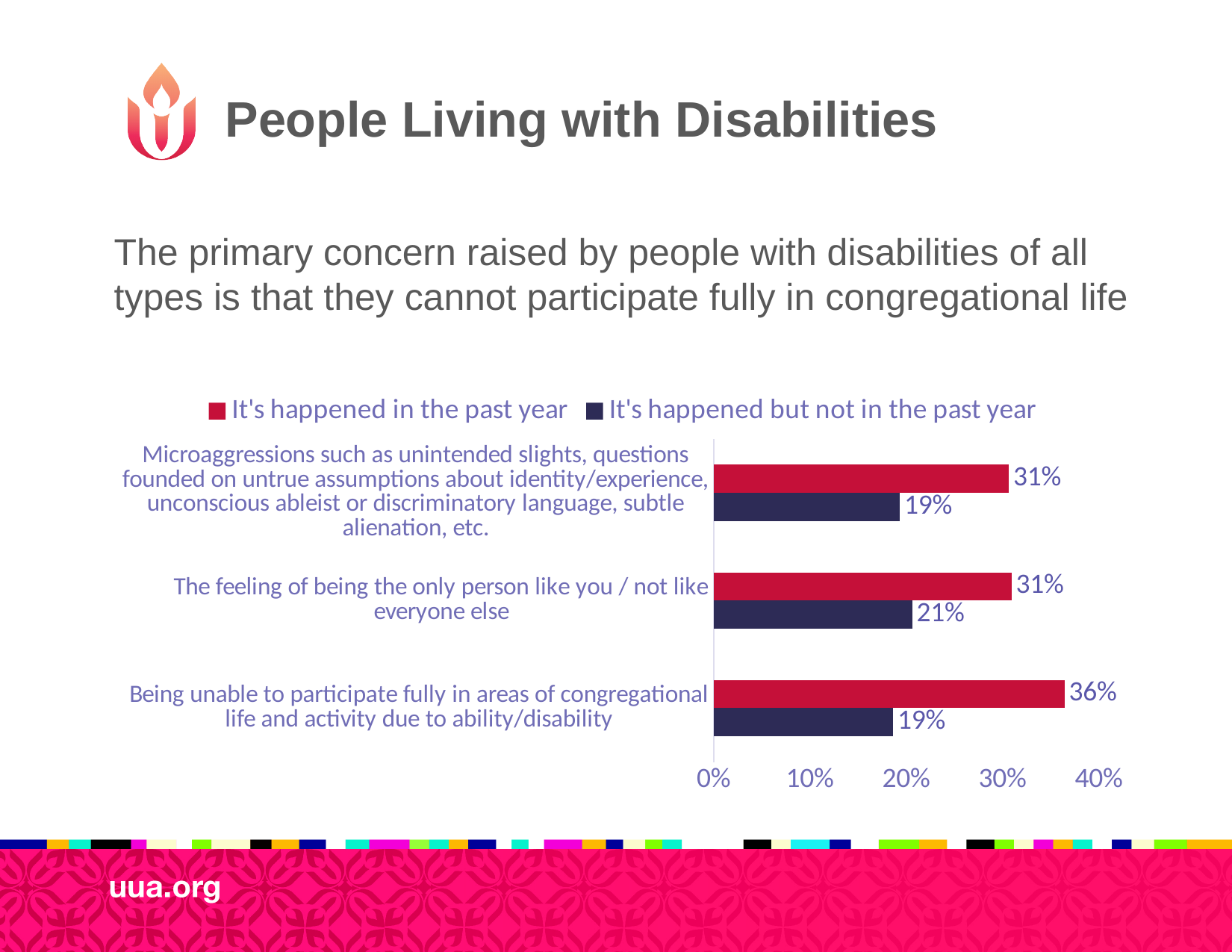
Which category has the highest value for "It's happened in the past year"? Being unable to participate fully in areas of congregational life and activity due to ability/disability What colour are the bars for "It's happened in the past year"? Red How many categories are plotted in the chart? 3 For the microaggressions category, which series has the larger value? It's happened in the past year Which category has the highest value for "It's happened but not in the past year"? The feeling of being the only person like you / not like everyone else What is the value for "It's happened but not in the past year" for "The feeling of being the only person like you / not like everyone else"? 21% What kind of chart is shown on the slide? Bar chart What is the value for "It's happened in the past year" for "Being unable to participate fully in areas of congregational life and activity due to ability/disability"? 36% Is the value for "It's happened but not in the past year" for the microaggressions category greater or less than 20%? less What is the difference between the two series for "Being unable to participate fully in areas of congregational life and activity due to ability/disability"? 17% What is the value for "It's happened in the past year" for the microaggressions category? 31% How many series does the legend list? 2